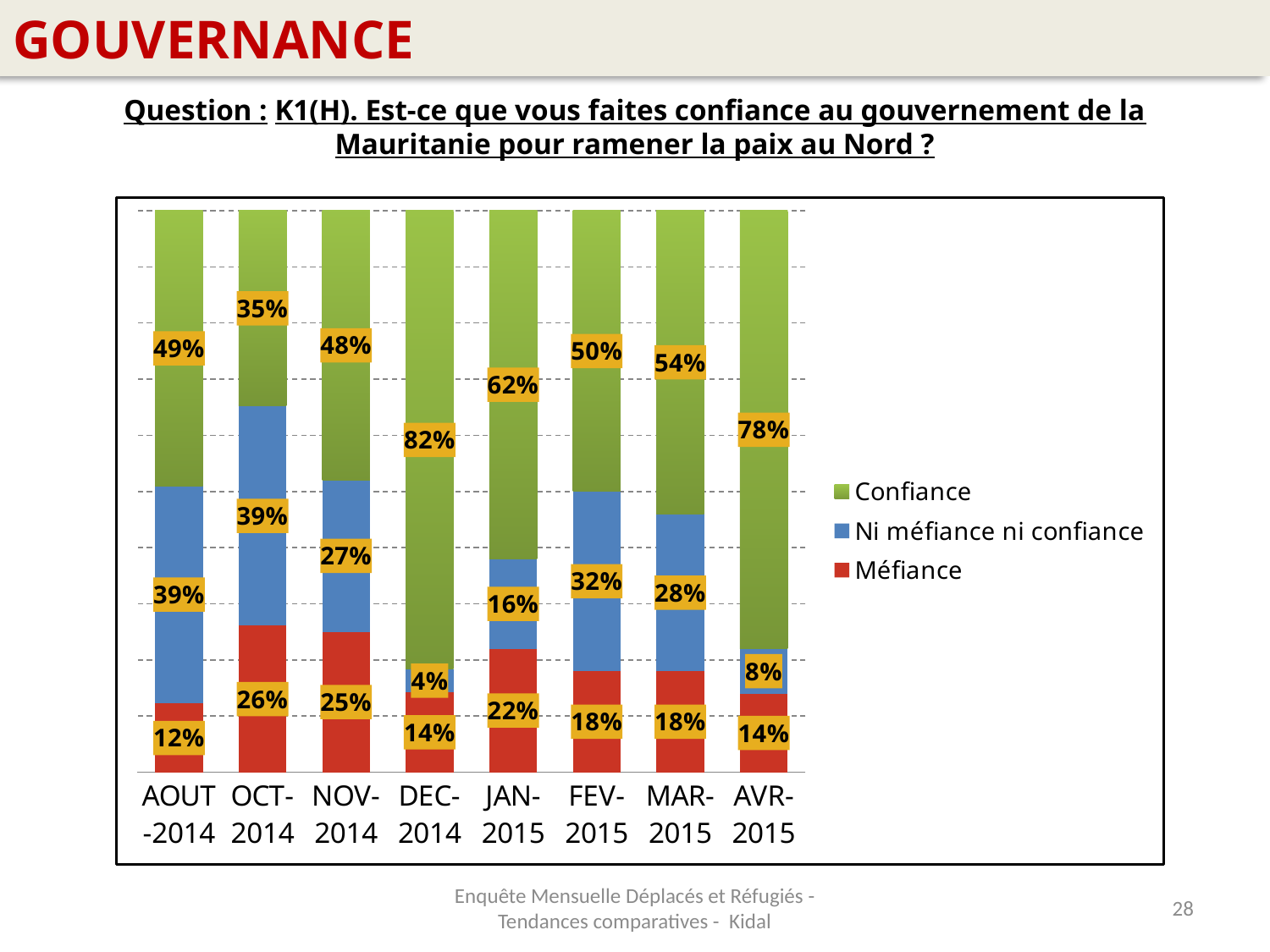
What is the 'Ni méfiance ni confiance' value for JAN-2015? 16% What is the Confiance value for DEC-2014? 82% What is the total of the three segments for NOV-2014? 100% What is the Méfiance value for OCT-2014? 26% In which month is the 'Ni méfiance ni confiance' value lowest? DEC-2014 What is the difference between the Confiance values for AVR-2015 and MAR-2015? 24% How many months are shown on the x axis? 8 What kind of chart is shown on the slide? Stacked bar chart How many series does the legend list? 3 In which month is the Confiance value highest? DEC-2014 Which series is shown in red in the legend? Méfiance Which is larger, the Méfiance value for JAN-2015 or for FEV-2015? JAN-2015